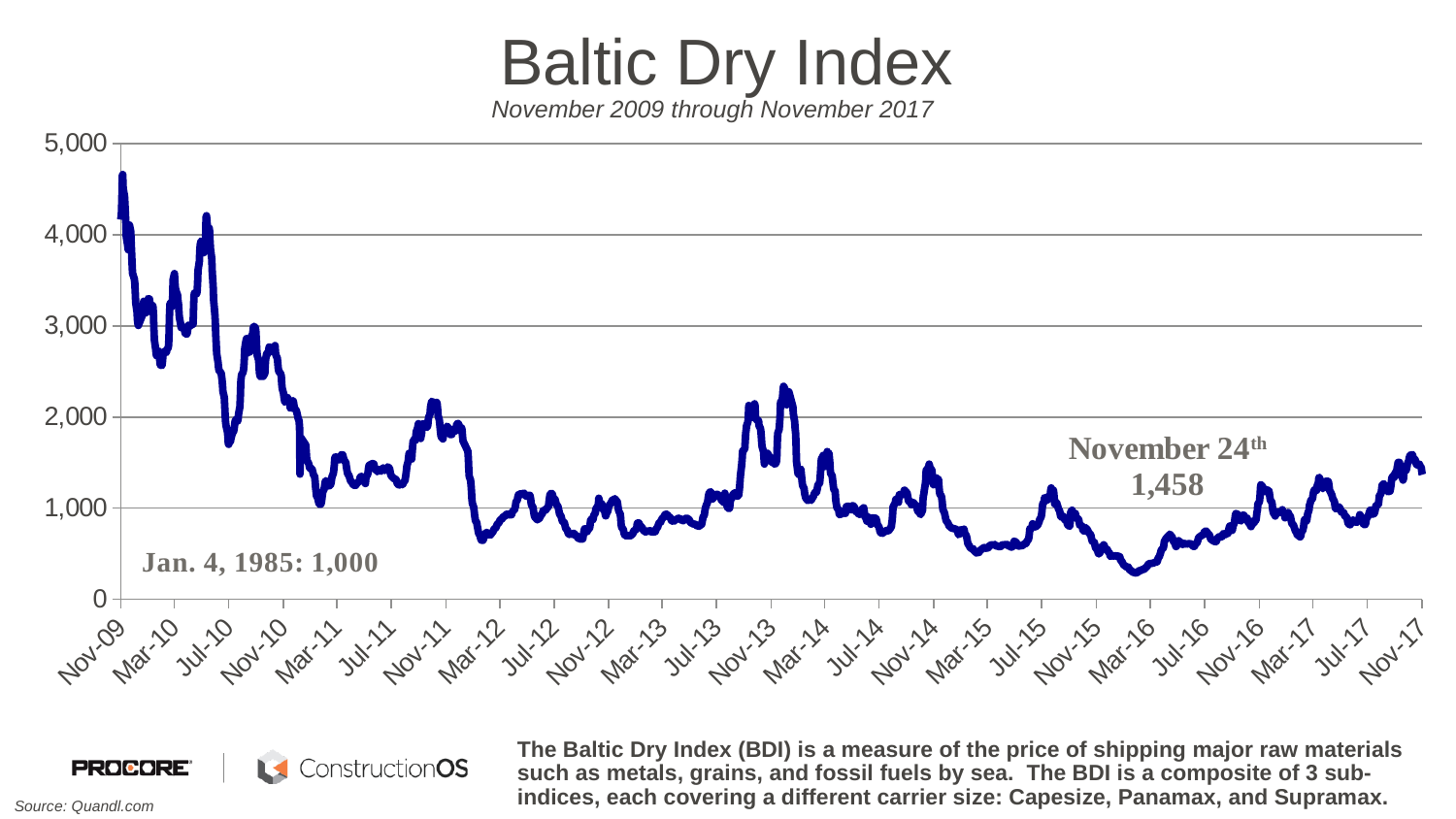
What time period does the chart cover, according to its subtitle? November 2009 through November 2017 Near which x-axis label does the index reach its highest value? Nov-09 Is the value of the index at Nov-09 greater or less than 4,000? greater Is the value of the index around Mar-16 greater or less than 1,000? less Which is larger, the index value at Nov-09 or at Nov-17? Nov-09 What kind of chart is shown on the slide? line chart What is the title of the chart? Baltic Dry Index Is the value of the index at Nov-17 greater or less than 1,000? greater What value is annotated for Jan. 4, 1985? 1,000 What value of the Baltic Dry Index is annotated for November 24th? 1,458 Overall, does the index rise or fall from Nov-09 to Nov-17? fall